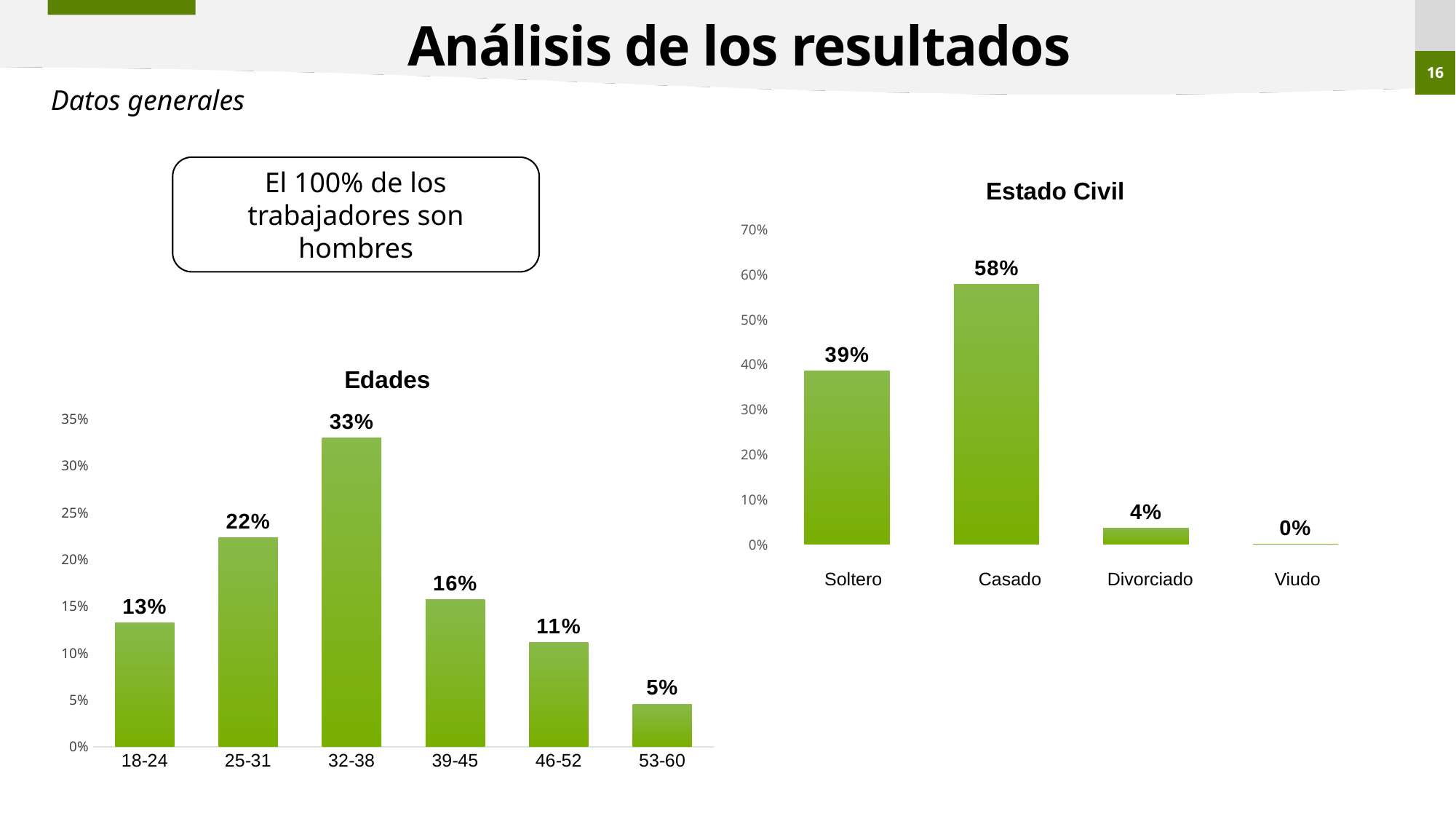
In the 'Edades' chart, how many age groups are shown? 6 In the 'Edades' chart, what is the difference between the values for 25-31 and 39-45? 6% In the 'Estado Civil' chart, what is the value for Viudo? 0% What kind of chart is the 'Estado Civil' chart? bar chart In the 'Edades' chart, which age group has the highest value? 32-38 In the 'Estado Civil' chart, what is the difference between Casado and Soltero? 19% In the 'Edades' chart, do the values rise or fall from 32-38 to 53-60? fall In the 'Estado Civil' chart, what is the value for Casado? 58% In the 'Estado Civil' chart, which is larger, Soltero or Divorciado? Soltero In the 'Estado Civil' chart, which category has the highest value? Casado In the 'Edades' chart, what is the value for the 32-38 age group? 33% In the 'Edades' chart, which age group has the lowest value? 53-60